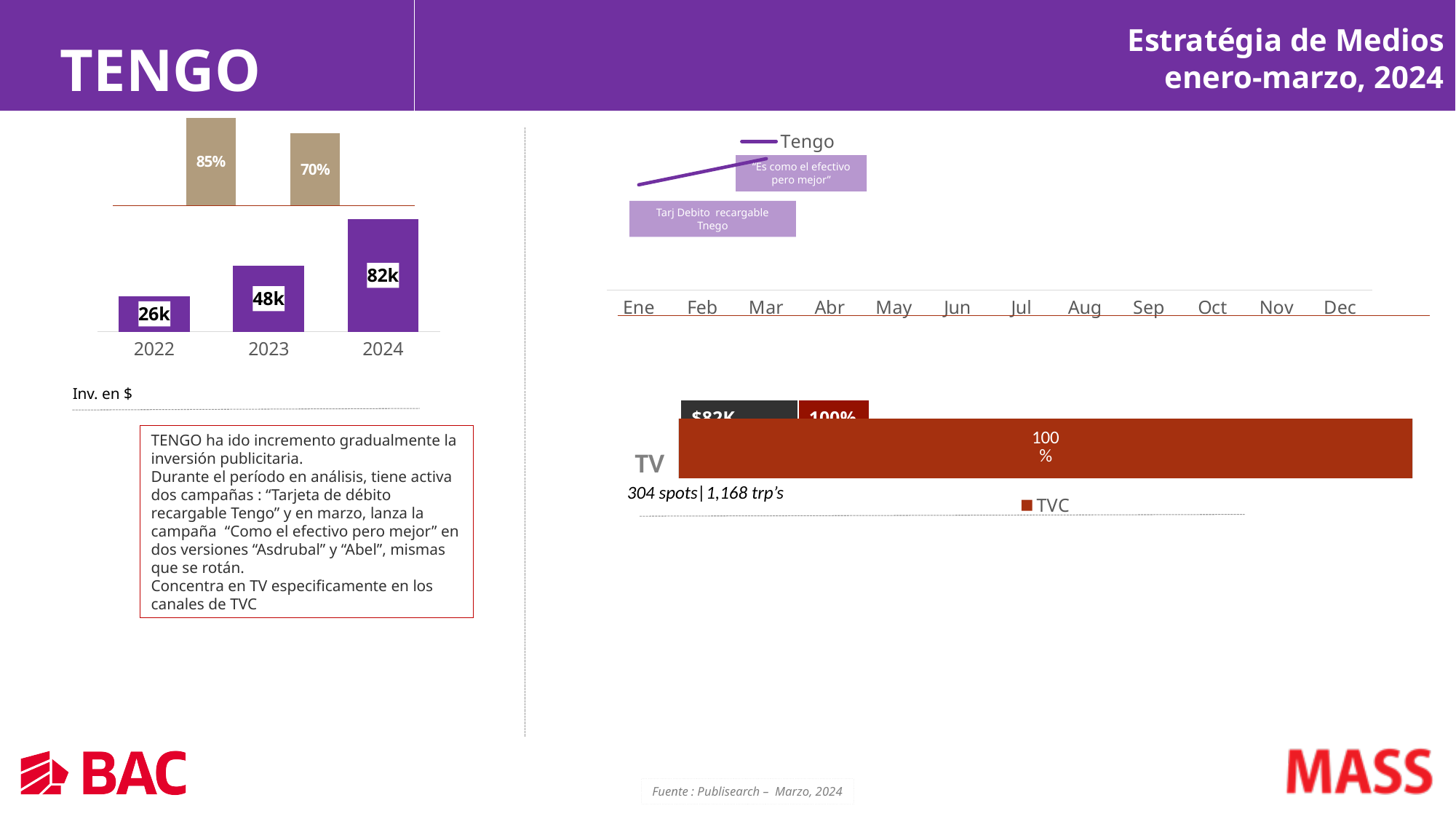
On the 'Inv. en $' chart, which year has the lowest investment? 2022 On the 'Inv. en $' chart, which year has the highest investment? 2024 On the 'Inv. en $' chart, what is the value for 2022? 26k On the 'Inv. en $' chart, what is the value for 2024? 82k On the 'Inv. en $' chart, what is the growth percentage shown above 2023? 85% On the TV chart on the right, what series does the legend list? TVC On the 'Inv. en $' chart, what is the growth percentage shown above 2024? 70% What kind of chart is the 'Inv. en $' chart? bar chart On the 'Inv. en $' chart, do the investment values rise or fall from 2022 to 2024? rise On the TV chart on the right, what percentage is shown for TVC? 100% On the 'Inv. en $' chart, how many years are shown? 3 On the 'Inv. en $' chart, what is the value for 2023? 48k